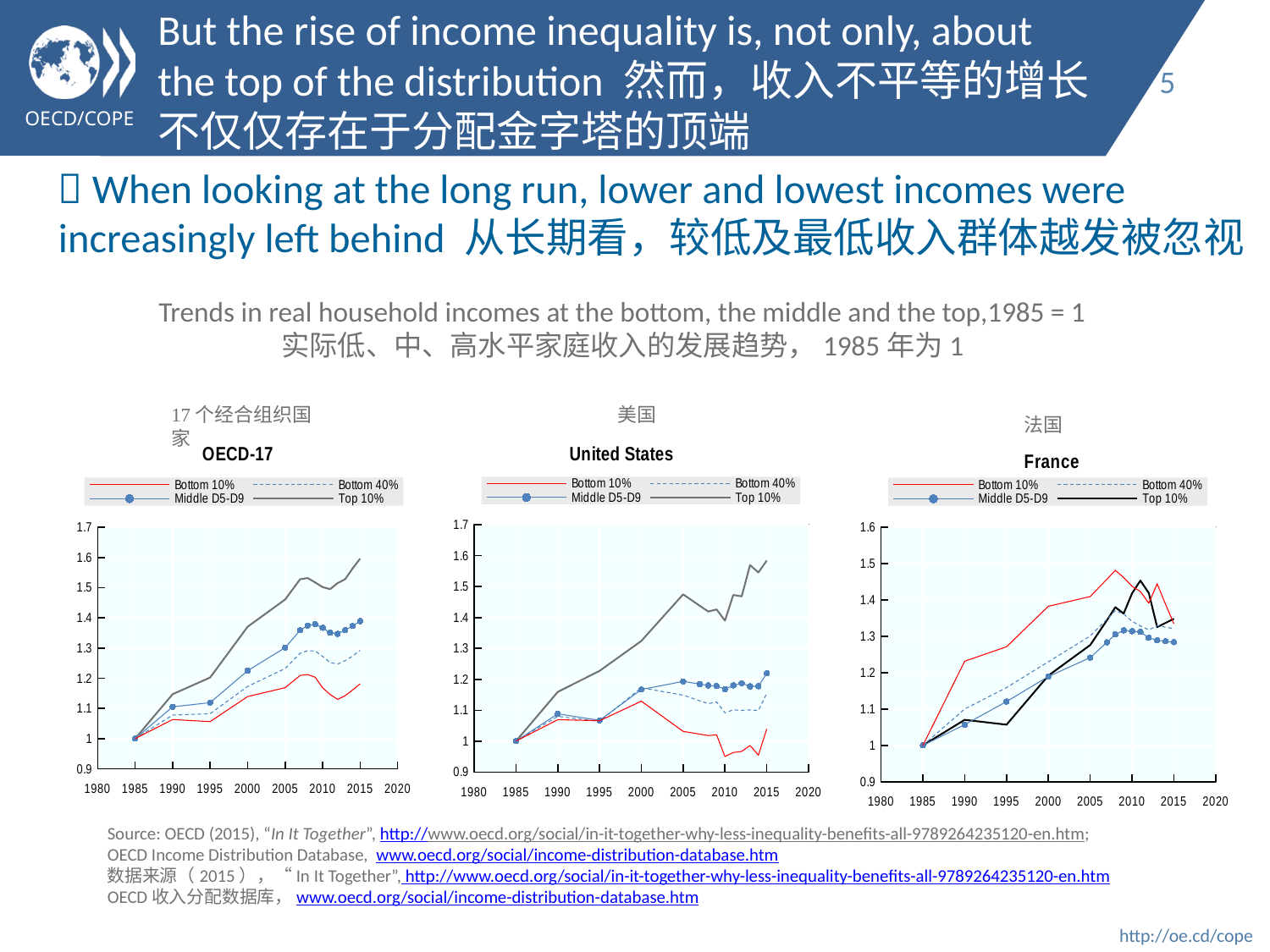
In the United States chart, is the value for Bottom 10% in 2015 greater or less than 1.1? less In the United States chart, which series is lowest in 2015? Bottom 10% How many charts are shown on the slide? 3 In the OECD-17 chart, what is the value of all series in 1985? 1 In the United States chart, which is larger in 2015, Top 10% or Bottom 10%? Top 10% In the United States chart, does the Bottom 10% series rise or fall between 2000 and 2015? fall In the OECD-17 chart, is the value for Top 10% in 2015 greater or less than 1.5? greater Which series is drawn with a dashed line in the legends of the three charts? Bottom 40% In the United States chart, is the value for Top 10% in 2015 greater or less than 1.5? greater What type of chart is used for the OECD-17 panel? line chart In the OECD-17 chart, which series is highest in 2015? Top 10% How many series does the legend of the United States chart list? 4